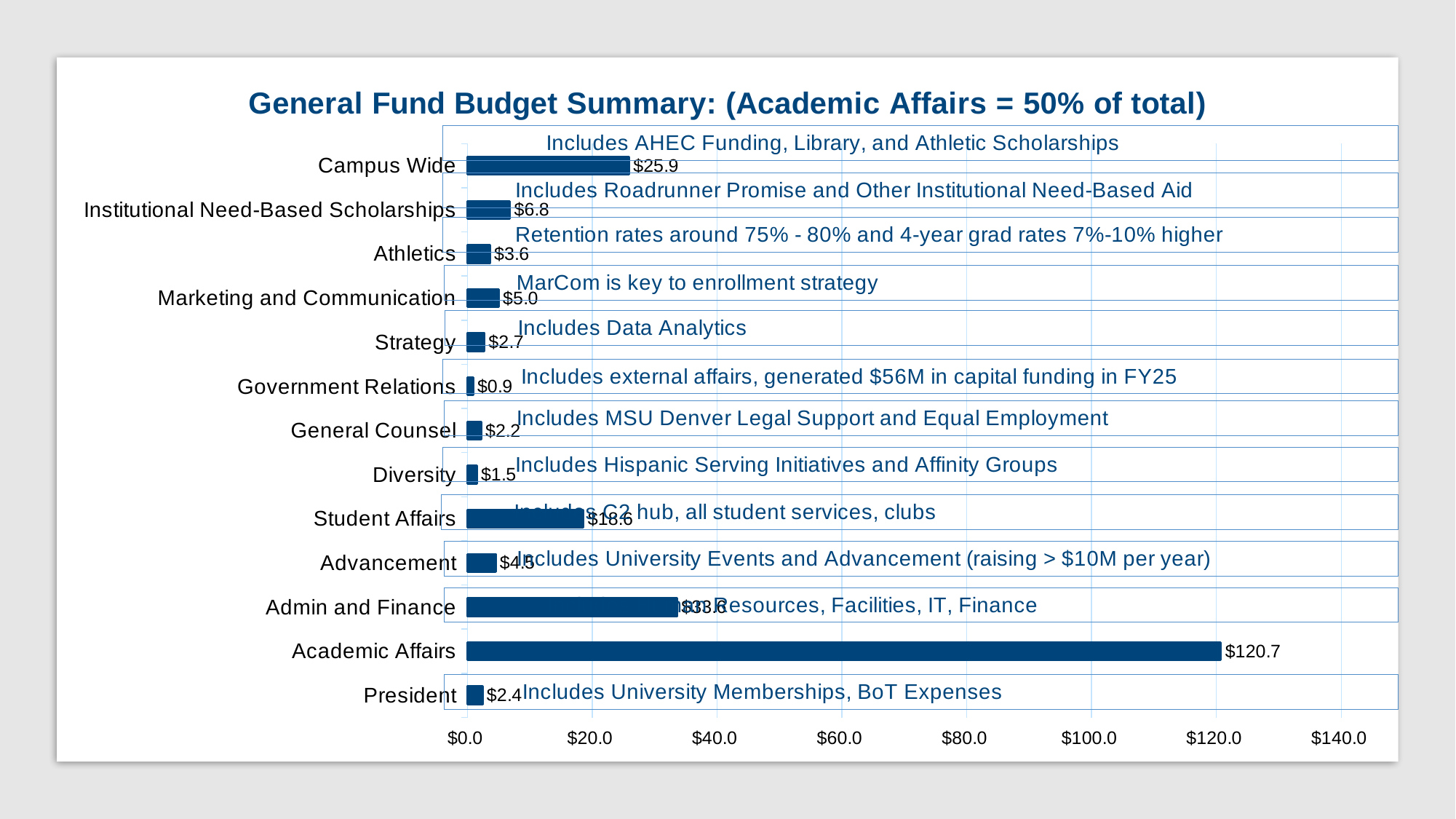
Which category has the highest value? Academic Affairs What is the difference between the values for Campus Wide and Student Affairs? $7.3 Which category has the lowest value? Government Relations What is the value for Diversity? $1.5 What is the value for Government Relations? $0.9 How many categories are shown in the chart? 13 What is the value for Academic Affairs? $120.7 What kind of chart is shown on the slide? bar chart Is the value for Admin and Finance greater or less than $20.0? greater Which is larger, the value for Athletics or the value for Marketing and Communication? Marketing and Communication What is the title of the chart? General Fund Budget Summary: (Academic Affairs = 50% of total) What is the value for Campus Wide? $25.9